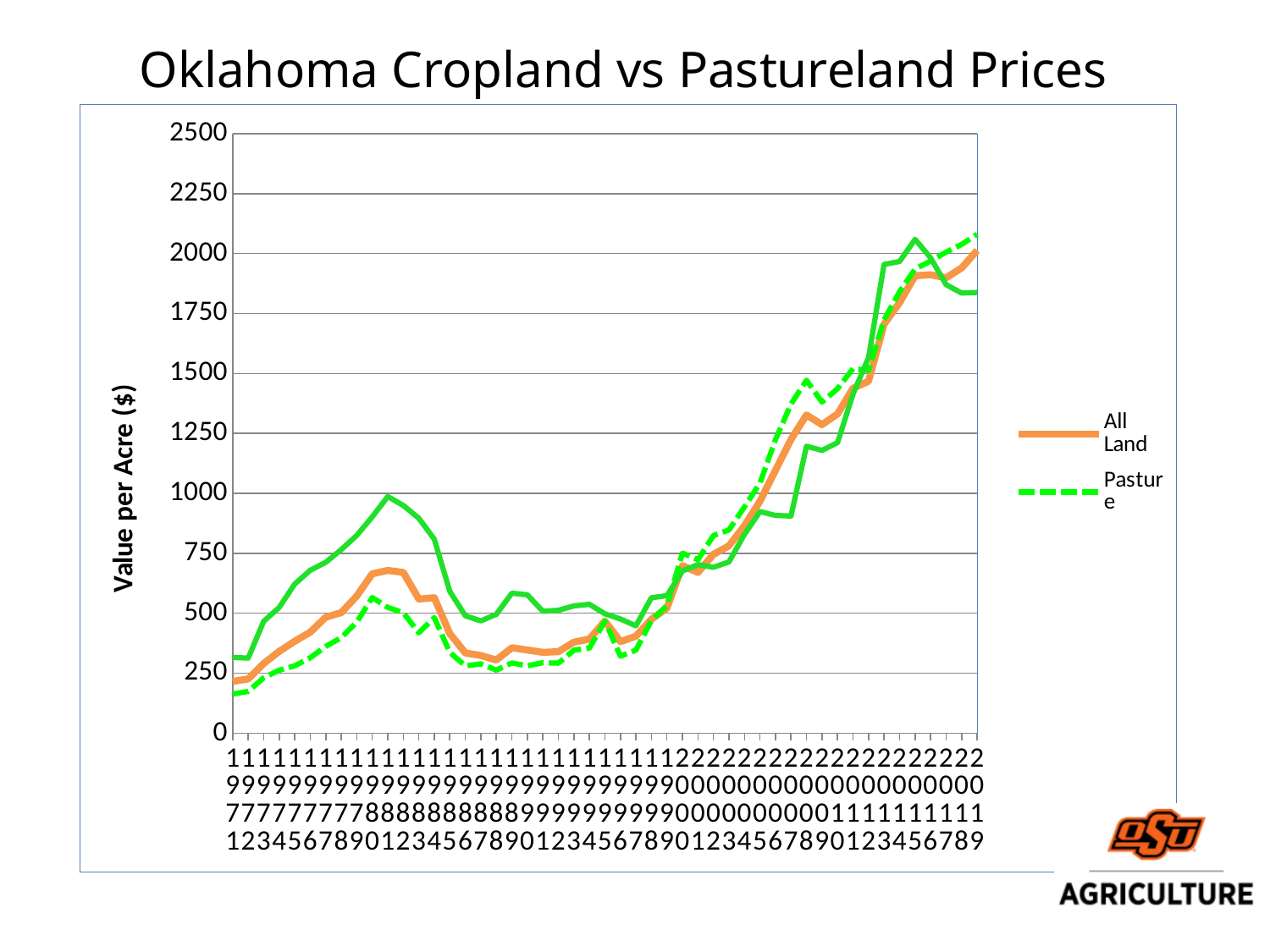
Is the All Land value in 1971 greater or less than 250? less What kind of chart is shown on the slide? Line chart What is the label on the vertical axis? Value per Acre ($) How many series does the legend list? 2 In 2008, which series has the higher value, All Land or Pasture? Pasture Is the Pasture value in 2008 greater or less than 1250? greater In 1971, which series has the higher value, All Land or Pasture? All Land Is the Pasture value in 1971 greater or less than 250? less In which year is the All Land value lowest? 1971 Overall, do the All Land values rise or fall from 1971 to 2019? Rise What is the title of the chart? Oklahoma Cropland vs Pastureland Prices